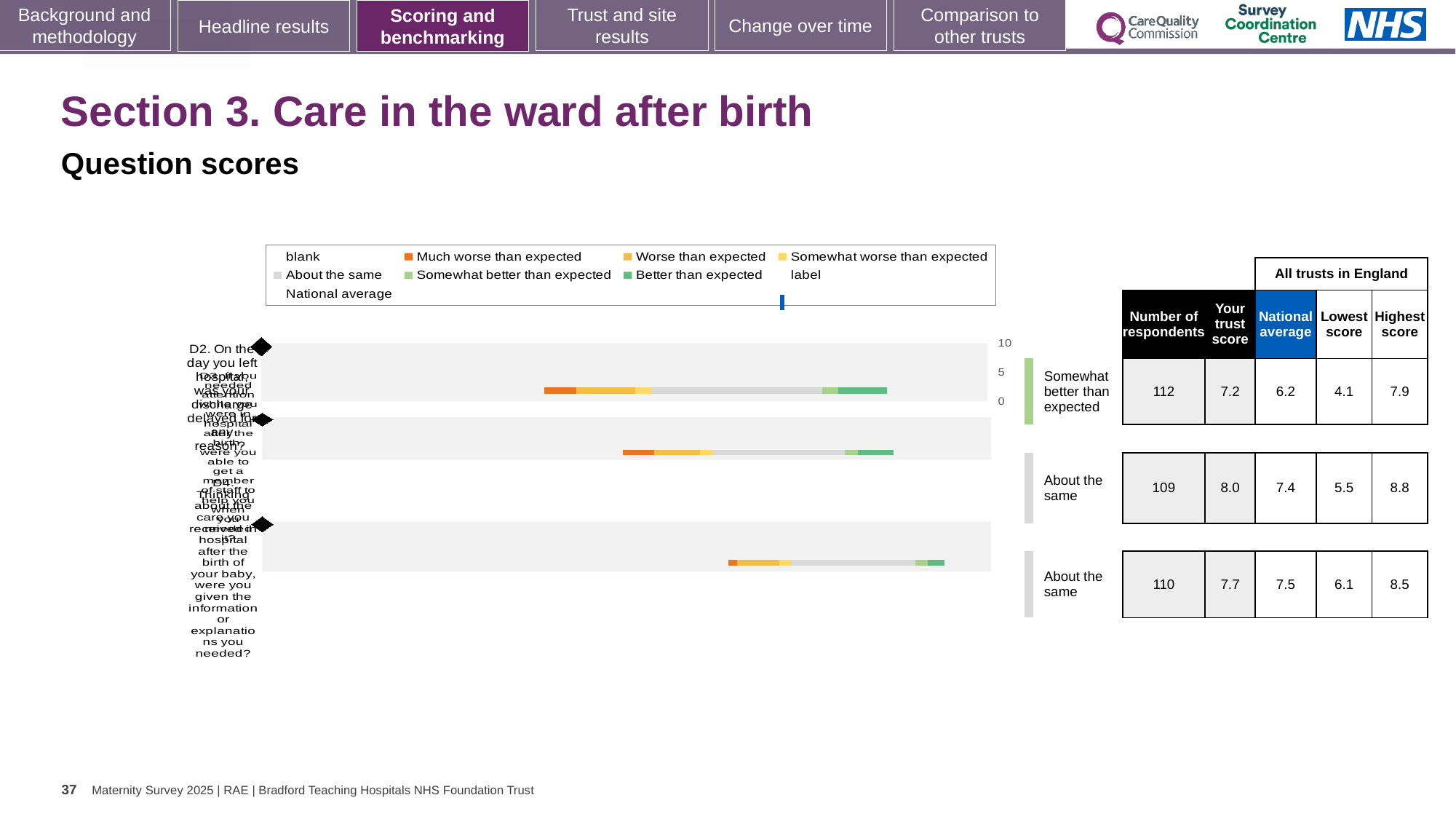
For the top row, what is the difference between 'Your trust score' and the national average? 1.0 Which row of the table is rated 'Somewhat better than expected'? the top row In the table, what is the number of respondents for the top row? 112 In the table, what is the highest score for the bottom row? 8.5 For the bottom row, is 'Your trust score' higher or lower than the national average? higher In the table, what is the national average for the middle row? 7.4 Which row of the table has the lowest 'Lowest score'? the top row (4.1) Which row of the table has the highest 'Your trust score'? the middle row (8.0) In the table, what is 'Your trust score' for the top row? 7.2 How many bars (questions) are plotted in the chart? 3 What kind of chart is shown on the slide? bar chart What does the blue marker in the legend represent? National average